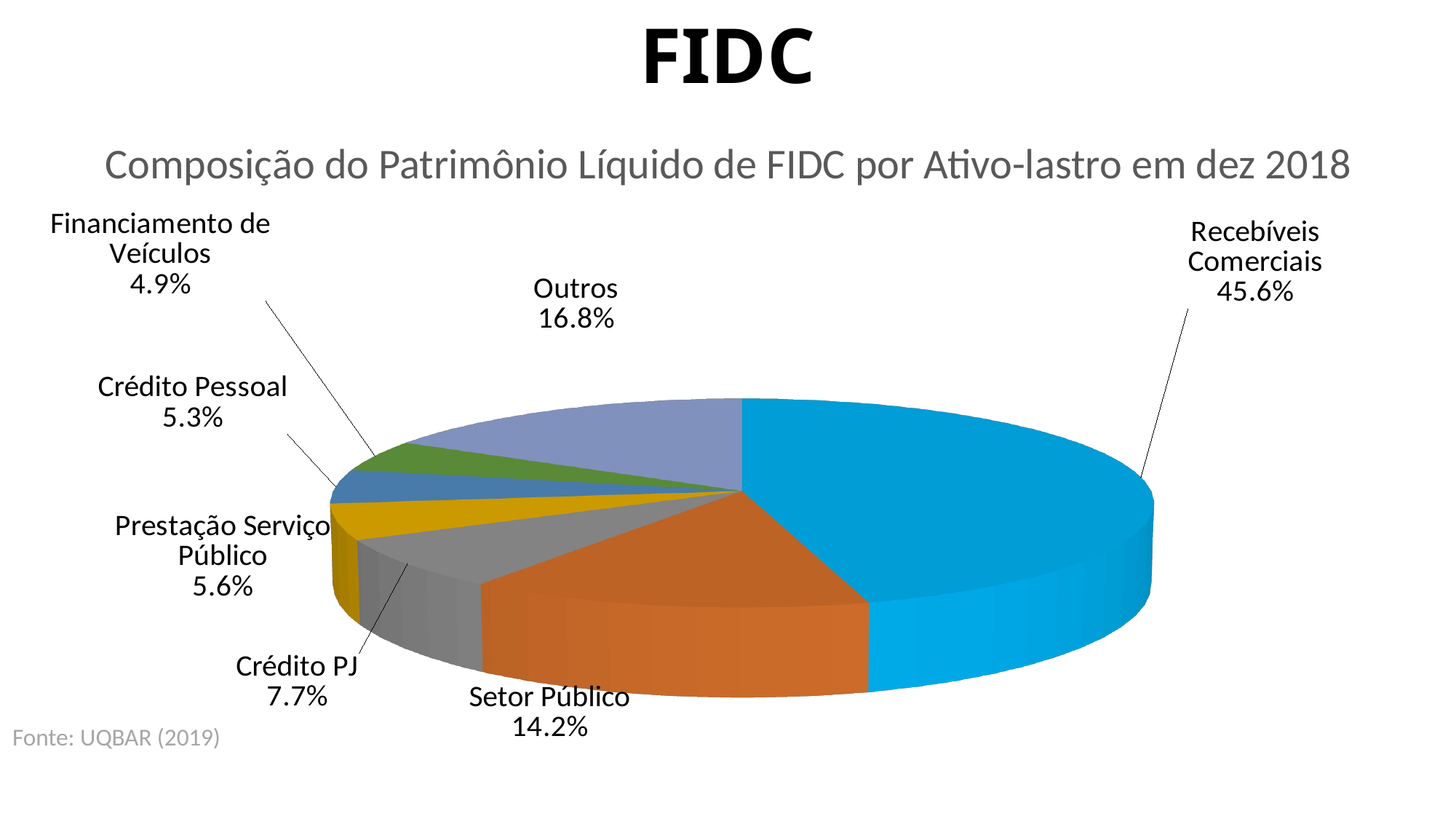
What is the title of the chart? Composição do Patrimônio Líquido de FIDC por Ativo-lastro em dez 2018 Which category has the smallest slice of the pie? Financiamento de Veículos Which is larger, Outros or Setor Público? Outros What share of the pie does Recebíveis Comerciais hold? 45.6% What is the difference in percentage points between Recebíveis Comerciais and Setor Público? 31.4 What is the value shown for Financiamento de Veículos? 4.9% Which category has the largest slice of the pie? Recebíveis Comerciais How many categories are shown in the pie chart? 7 What kind of chart is shown on the slide? Pie chart What is the value shown for Setor Público? 14.2% What is the value shown for Outros? 16.8% What is the value shown for Crédito PJ? 7.7%